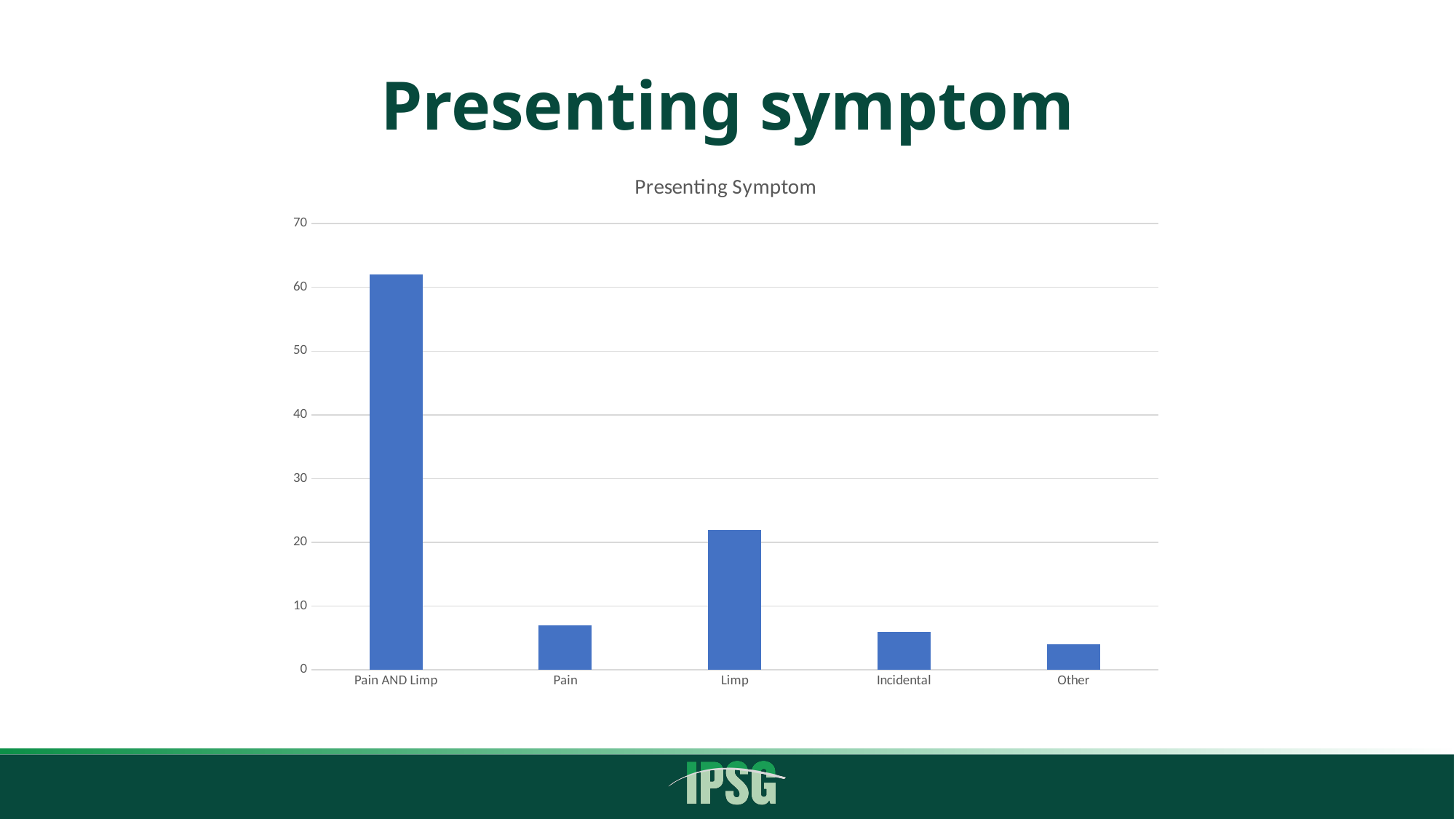
Which has a larger value, Incidental or Other? Incidental What is the title of the chart? Presenting Symptom Which presenting symptom has the highest value? Pain AND Limp Is the value for Other greater or less than 10? less Which presenting symptom has the lowest value? Other Which has a larger value, Limp or Pain? Limp Is the value for Pain greater or less than 10? less What kind of chart is shown on the slide? bar chart Which has a larger value, Pain AND Limp or Limp? Pain AND Limp Is the value for Pain AND Limp greater or less than 60? greater How many categories are shown on the x axis of the chart? 5